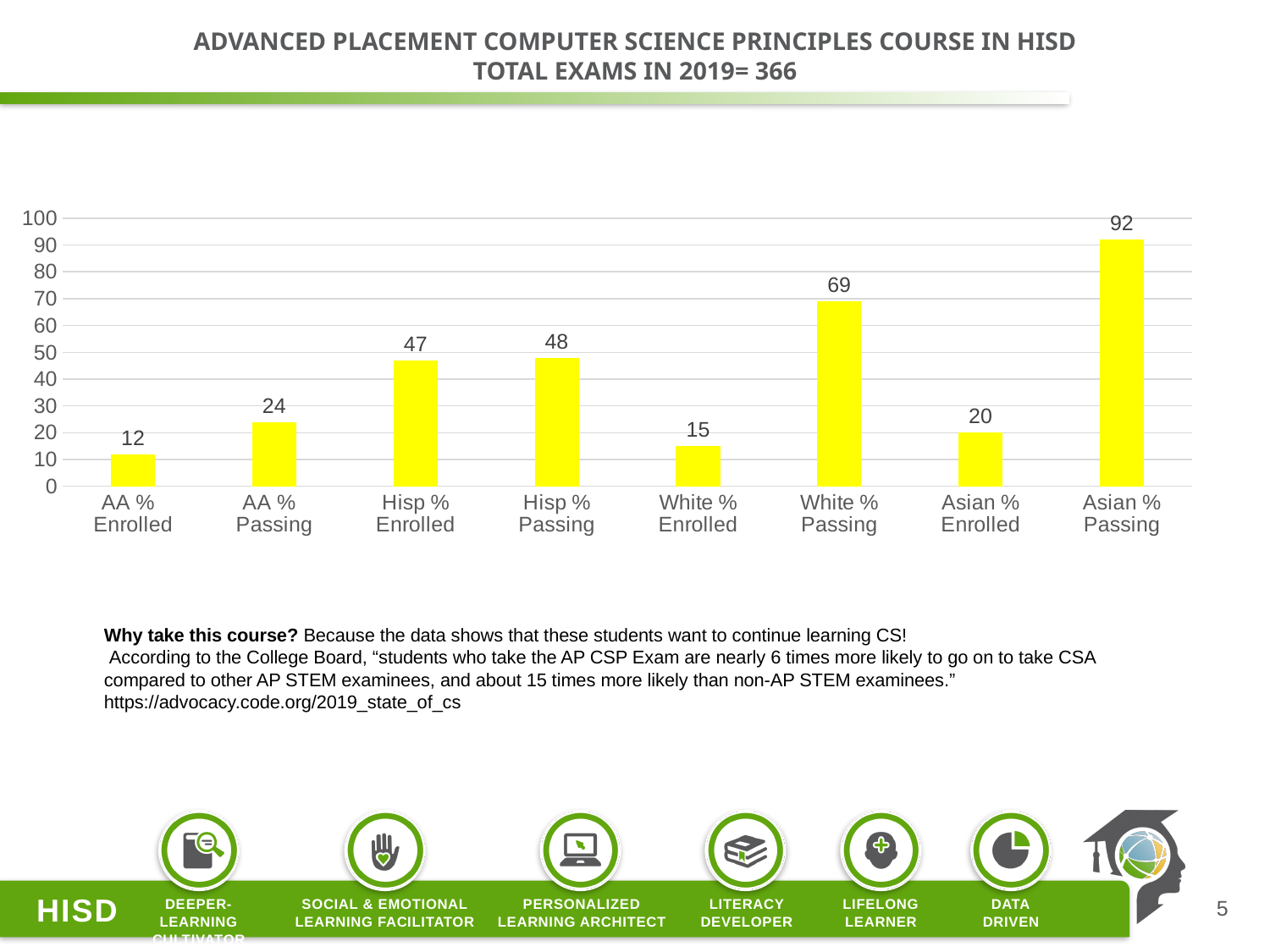
What is the value for Hisp % Enrolled? 47 Which category has the lowest value? AA % Enrolled What kind of chart is shown on the slide? bar chart Is the value for Hisp % Passing greater or less than 40? greater Which is larger, AA % Passing or Asian % Enrolled? AA % Passing What colour are the bars in the chart? yellow What is the difference between Asian % Passing and Asian % Enrolled? 72 Which category has the highest value? Asian % Passing What is the value for AA % Enrolled? 12 How many categories are shown on the x axis? 8 What is the difference between White % Passing and White % Enrolled? 54 What is the value for White % Passing? 69